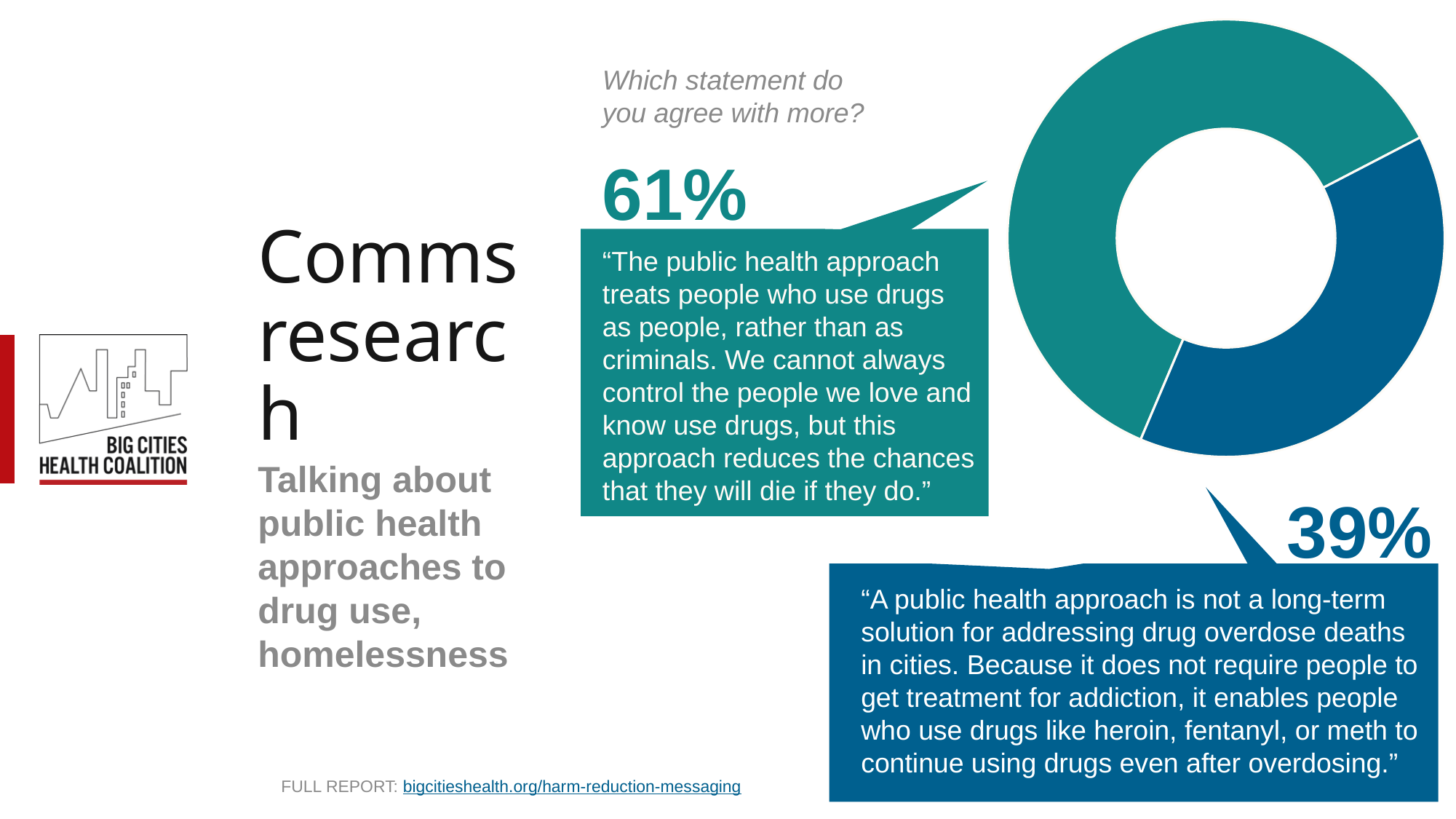
How many slices does the donut chart have? 2 What do the two slices of the donut chart add up to? 100% What kind of chart is shown on the slide? Donut (pie) chart Is the share for the 'treats people who use drugs as people' statement larger or smaller than the share for the 'not a long-term solution' statement? Larger What colour is the slice representing 61%? Teal What is the difference in percentage points between the two slices of the donut chart? 22 percentage points What colour is the slice representing 39%? Dark blue Which statement received the smaller share of agreement? "A public health approach is not a long-term solution for addressing drug overdose deaths in cities..." Which statement received the larger share of agreement? "The public health approach treats people who use drugs as people, rather than as criminals..." What share of respondents agreed more with the statement that the public health approach treats people who use drugs as people rather than criminals? 61% What question were respondents asked, according to the text above the chart? Which statement do you agree with more? What share of respondents agreed more with the statement that a public health approach is not a long-term solution for addressing drug overdose deaths? 39%